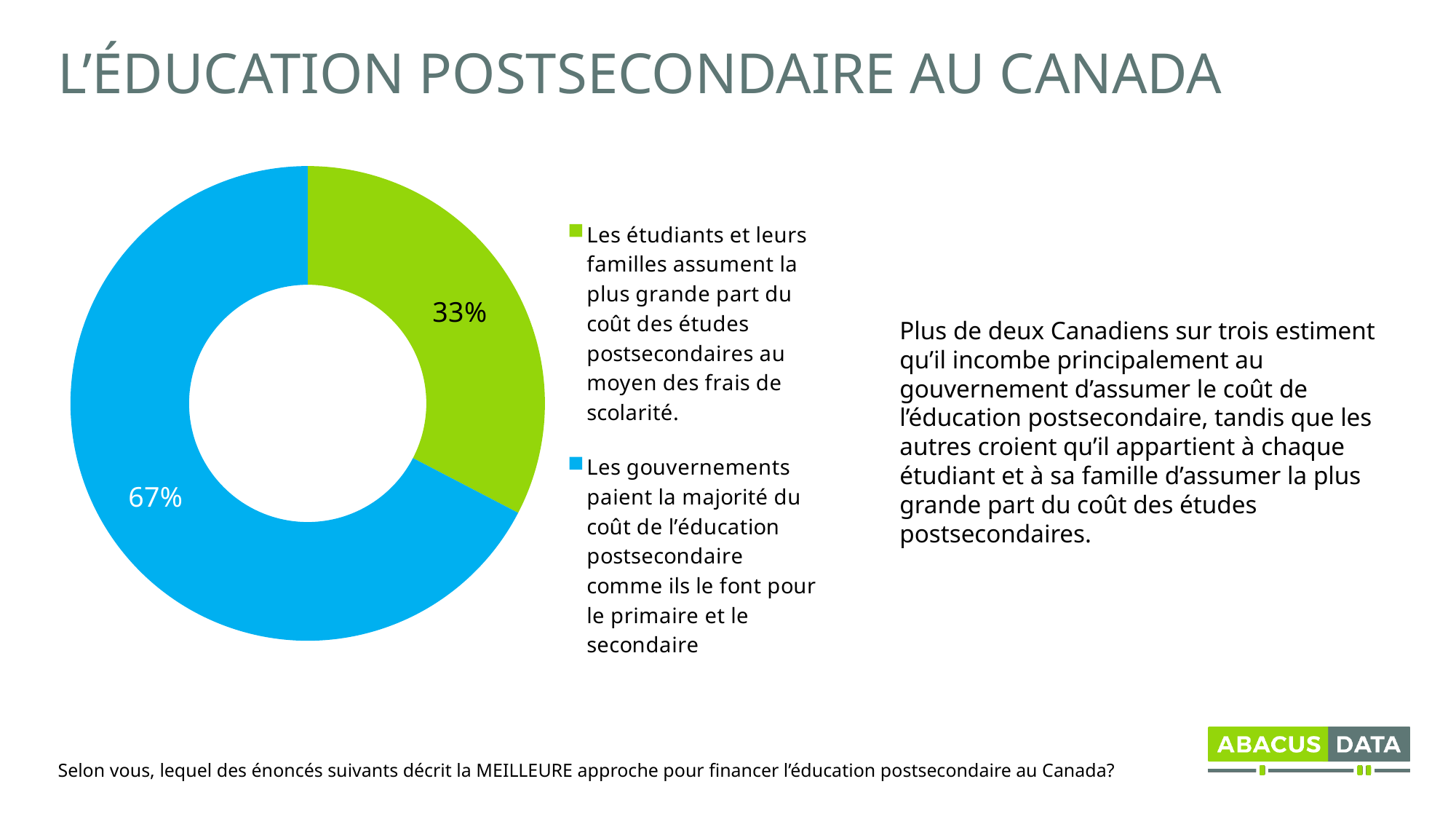
What percentage of respondents say governments should pay the majority of the cost of postsecondary education? 67% How many slices does the pie chart have? 2 What is the total of the two slices shown in the pie chart? 100% What is the difference in percentage points between the government option and the students-and-families option? 34 What percentage of respondents say students and their families should assume the largest share of the cost of postsecondary studies? 33% How many entries does the legend list? 2 Which option has the largest share of the pie? Les gouvernements paient la majorité du coût de l'éducation postsecondaire comme ils le font pour le primaire et le secondaire What colour is the slice representing students and their families assuming the largest share of the cost? Green What colour is the slice representing governments paying the majority of the cost? Blue What kind of chart is shown on the slide? Pie chart (doughnut) Which is larger: the share for governments paying the majority or the share for students and families paying the largest part? Governments paying the majority Which option has the smallest share of the pie? Les étudiants et leurs familles assument la plus grande part du coût des études postsecondaires au moyen des frais de scolarité.